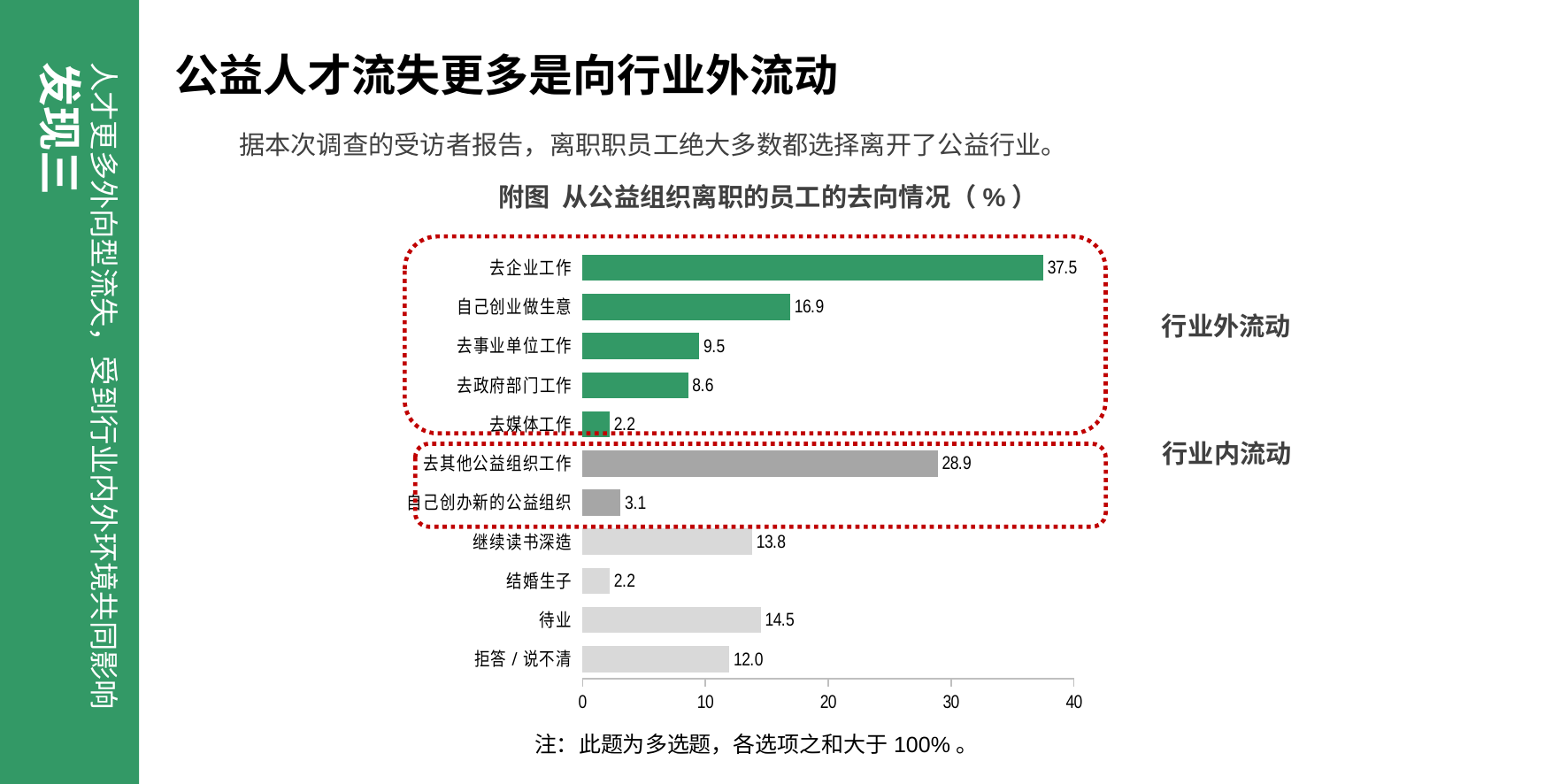
How many categories are shown in the chart? 11 What is the lowest value shown in the chart? 2.2 What is the value for 去其他公益组织工作? 28.9 Which category has the highest value? 去企业工作 What is the title of the chart? 附图 从公益组织离职的员工的去向情况（%） What is the value for 拒答／说不清? 12.0 What type of chart is shown on the slide? bar chart Which is larger, the value for 待业 or the value for 继续读书深造? 待业 What is the difference between the values for 去企业工作 and 去其他公益组织工作? 8.6 Is the value for 去其他公益组织工作 greater or less than 20? greater What is the value for 去企业工作? 37.5 What is the value for 自己创业做生意? 16.9